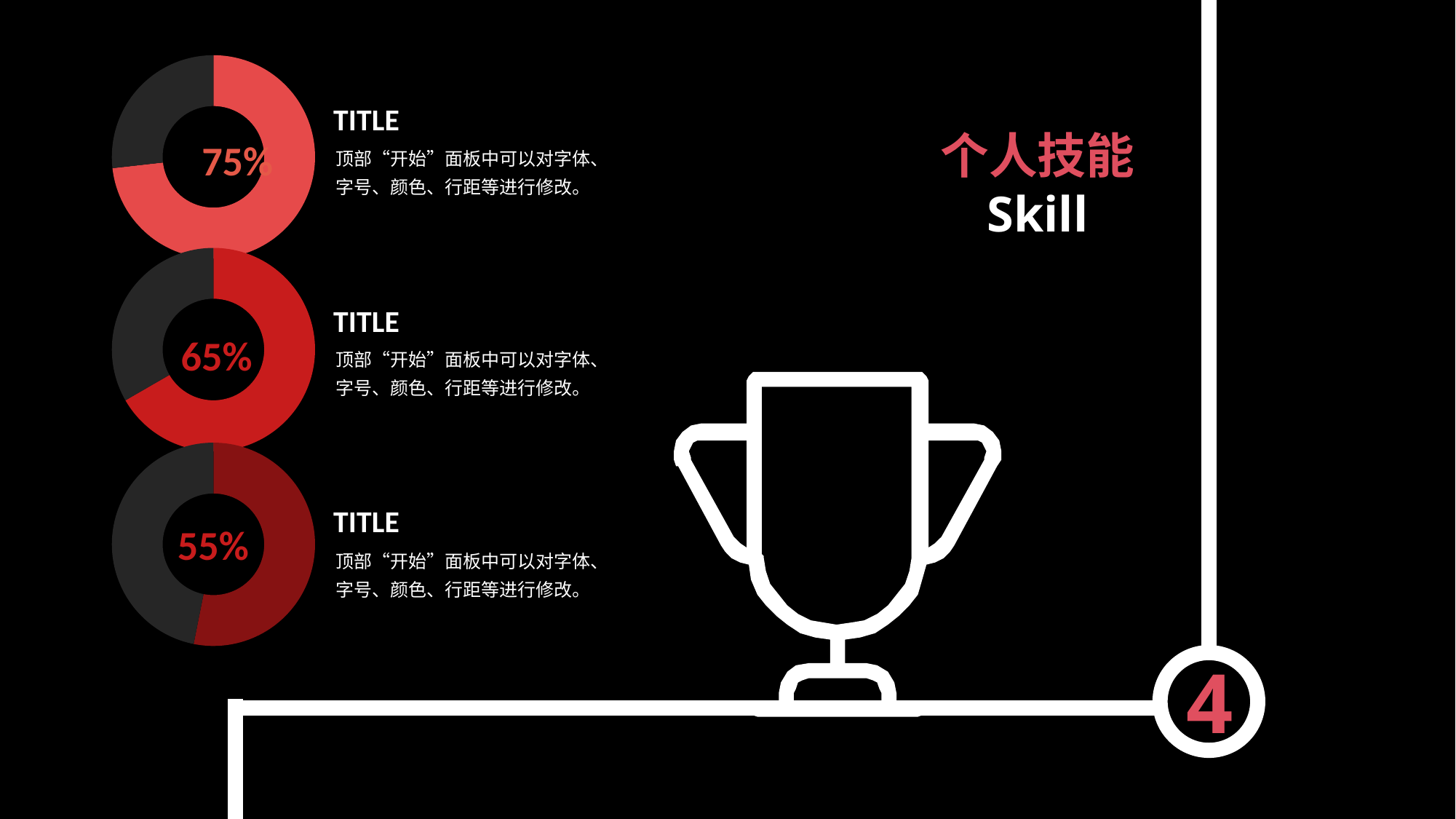
Which of the three doughnut charts shows the lowest percentage: top, middle or bottom? bottom What percentage is shown in the centre of the middle doughnut chart? 65% What is the difference between the percentage in the top doughnut chart and the percentage in the middle doughnut chart? 10% Which of the three doughnut charts shows the highest percentage: top, middle or bottom? top Do the percentages in the doughnut charts increase or decrease from the top chart to the bottom chart? decrease What is the heading text shown in red at the top right of the slide? 个人技能 What is the difference between the percentage in the top doughnut chart and the percentage in the bottom doughnut chart? 20% What percentage is shown in the centre of the top doughnut chart? 75% What kind of chart is used to show the percentages on the left of the slide? doughnut chart Is the percentage in the middle doughnut chart larger or smaller than the percentage in the bottom doughnut chart? larger What percentage is shown in the centre of the bottom doughnut chart? 55% How many doughnut charts are on the slide? 3